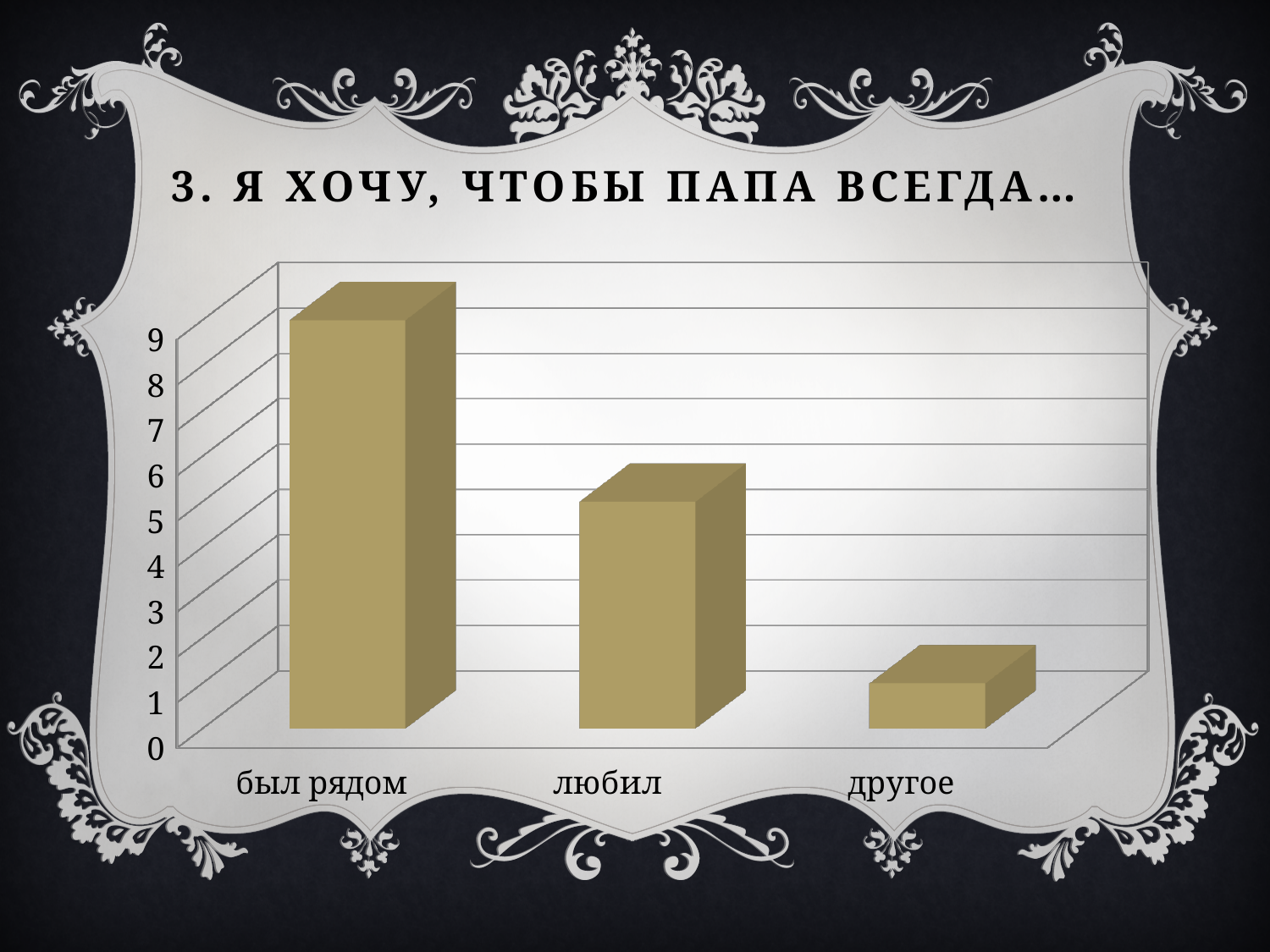
Which is larger, the value for "был рядом" or the value for "любил"? был рядом How many categories are shown on the x axis of the chart? 3 Is the value for "любил" greater or less than 3? greater Do the bar values rise or fall from left to right along the x axis? fall Is the value for "любил" greater or less than 7? less Which category has the lowest bar? другое Which category has the highest bar? был рядом What kind of chart is shown on the slide? bar chart Is the value for "другое" greater or less than 2? less Which is larger, the value for "любил" or the value for "другое"? любил What is the title of the slide containing the chart? 3. Я хочу, чтобы папа всегда…